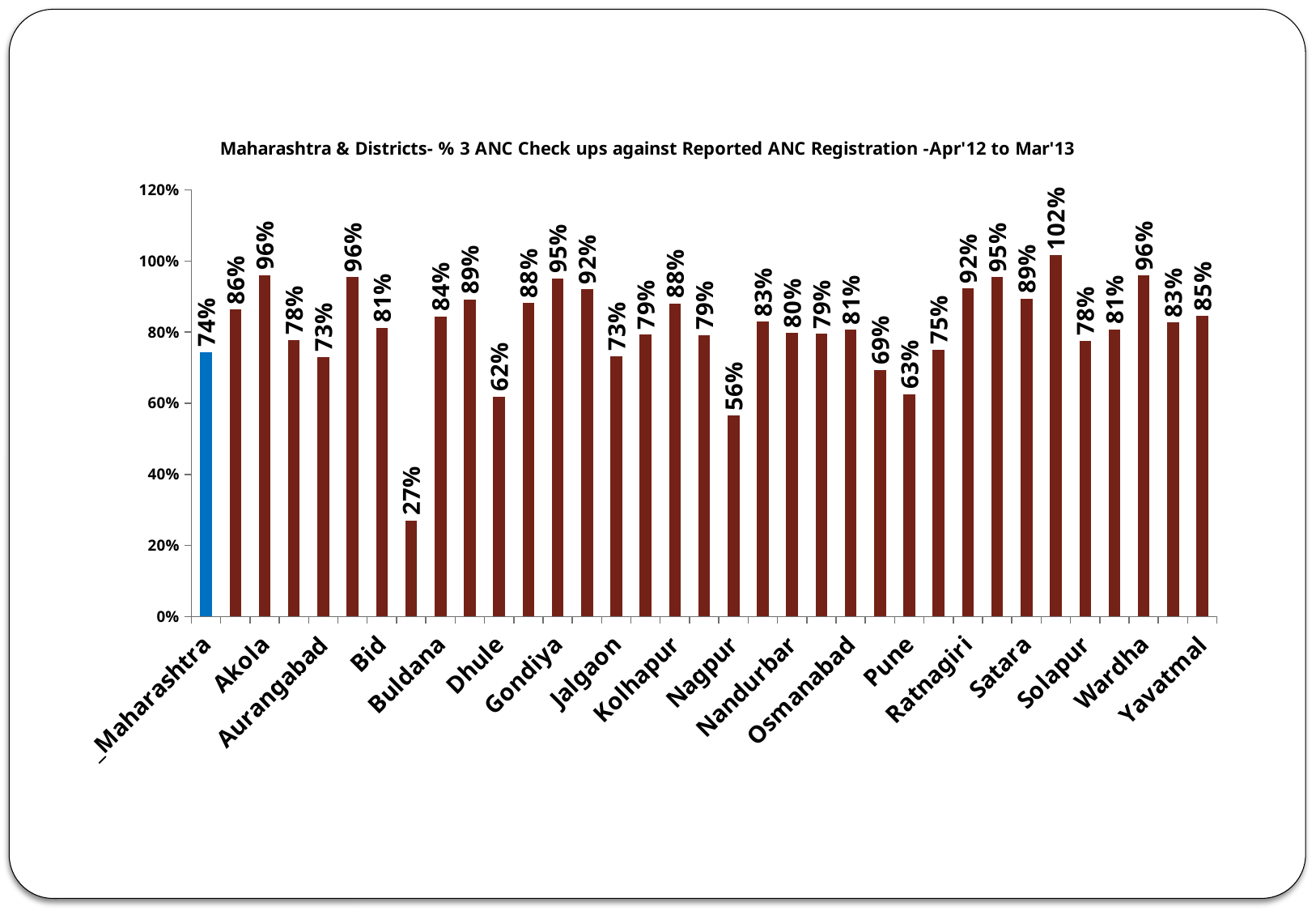
What is the value for Nagpur? 56% Which is larger, the value for Satara or the value for Jalgaon? Satara What is the value for Maharashtra? 74% What kind of chart is shown on the slide? Bar chart What is the value for Yavatmal? 85% Which bar is coloured blue rather than dark red? Maharashtra What is the value for Ratnagiri? 92% Is the value for Nagpur greater or less than 60%? less Is the value for Kolhapur greater or less than 80%? greater What is the value for Pune? 63% What is the difference between the values for Wardha and Solapur? 18% Which is larger, the value for Gondiya or the value for Dhule? Gondiya